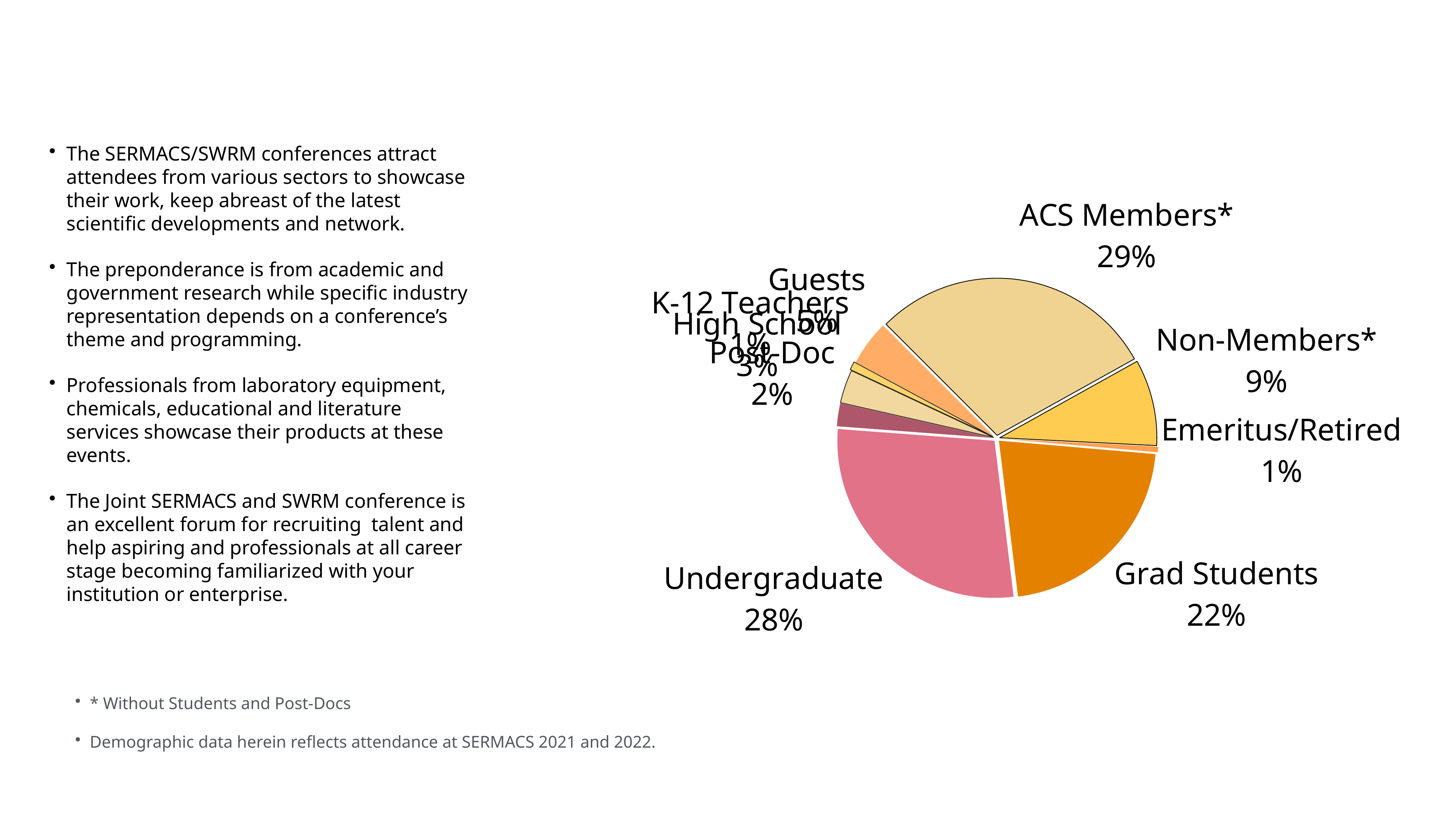
What is the difference in percentage points between ACS Members* and Non-Members*? 20 What is the difference in percentage points between Undergraduate and Grad Students? 6 What share is shown for Emeritus/Retired? 1% What share of the pie does ACS Members* represent? 29% What kind of chart is shown on the slide? Pie chart What does the asterisk after ACS Members* and Non-Members* indicate, according to the footnote? Without Students and Post-Docs What percentage of attendees are Undergraduate? 28% What percentage is shown for Non-Members*? 9% What is the value shown for Grad Students? 22% Which is larger, the share for Grad Students or the share for Non-Members*? Grad Students Which category has the largest share of the pie? ACS Members* Which is larger, the share for Non-Members* or the share for Emeritus/Retired? Non-Members*